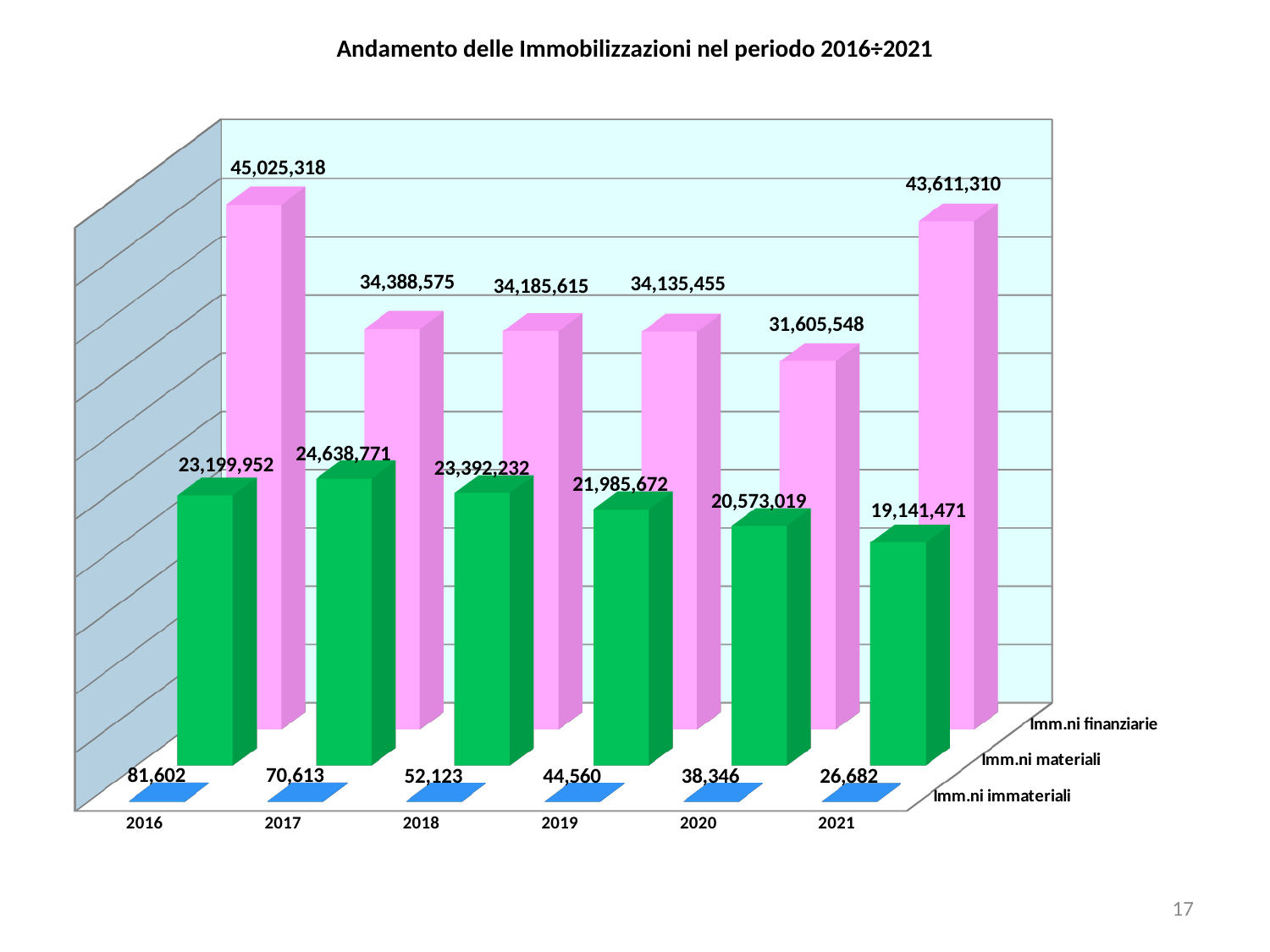
Do the values of Imm.ni immateriali rise or fall from 2016 to 2021? Fall Which is larger: Imm.ni finanziarie in 2020 or Imm.ni finanziarie in 2021? Imm.ni finanziarie in 2021 What is the value of Imm.ni immateriali in 2021? 26,682 How many years are shown on the x axis? 6 In which year is Imm.ni materiali highest? 2017 What is the value of Imm.ni materiali in 2019? 21,985,672 What is the difference between Imm.ni finanziarie in 2016 and in 2021? 1,414,008 In which year is Imm.ni finanziarie highest? 2016 In which year is Imm.ni materiali lowest? 2021 What is the value of Imm.ni finanziarie in 2016? 45,025,318 How many series does the chart show? 3 What kind of chart is shown on the slide? Bar chart